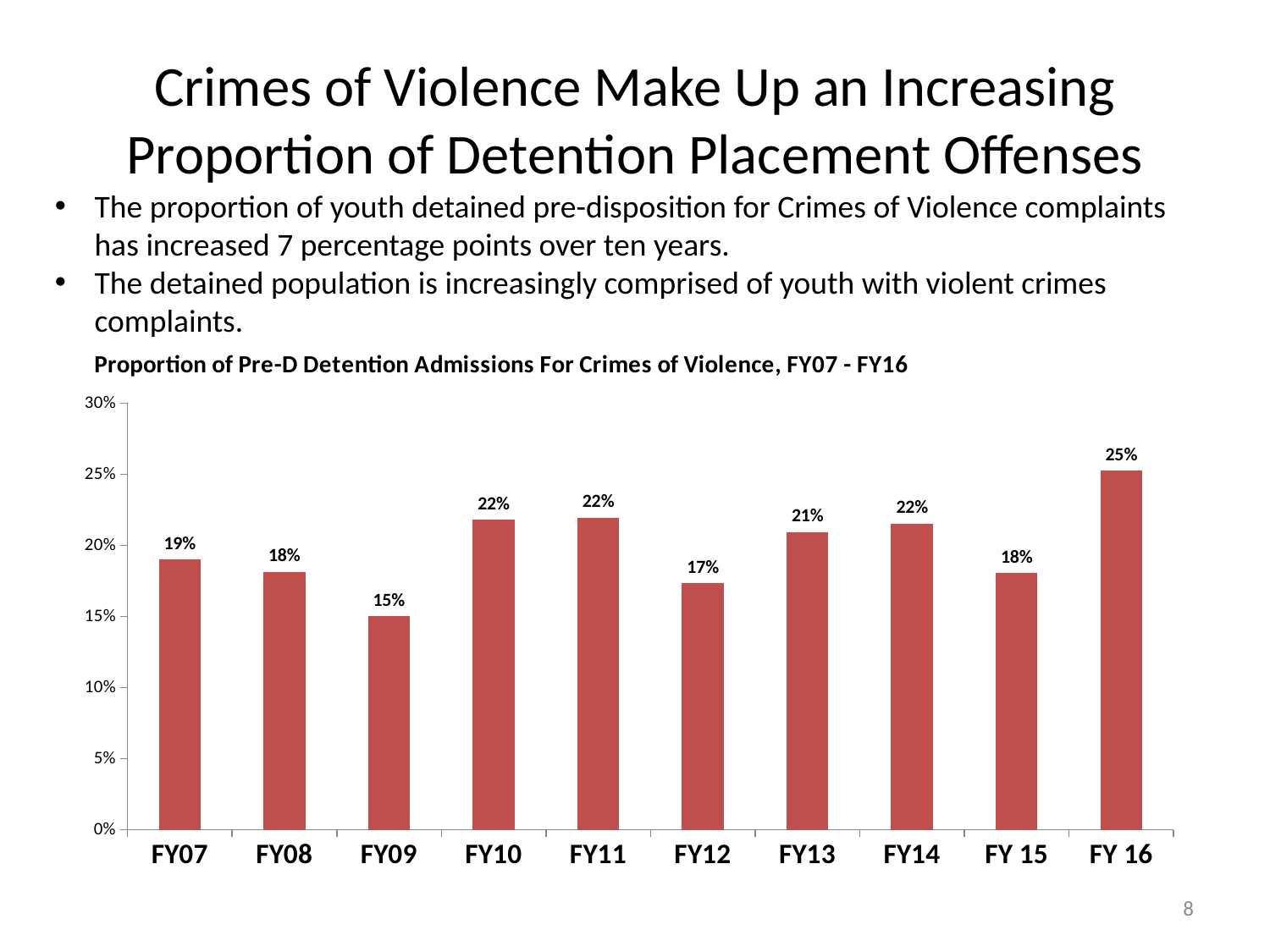
What is the title of the chart? Proportion of Pre-D Detention Admissions For Crimes of Violence, FY07 - FY16 Which fiscal year has the lowest proportion? FY09 Which is larger, the value for FY13 or the value for FY 15? FY13 Which fiscal year has the highest proportion? FY 16 Does the value rise or fall from FY 15 to FY 16? rise What is the value for FY 16? 25% How many fiscal years are shown on the x axis? 10 What kind of chart is shown on the slide? bar chart What is the difference between the values for FY 16 and FY09? 10% What is the value for FY07? 19% Is the value for FY10 greater or less than 20%? greater What is the value for FY12? 17%